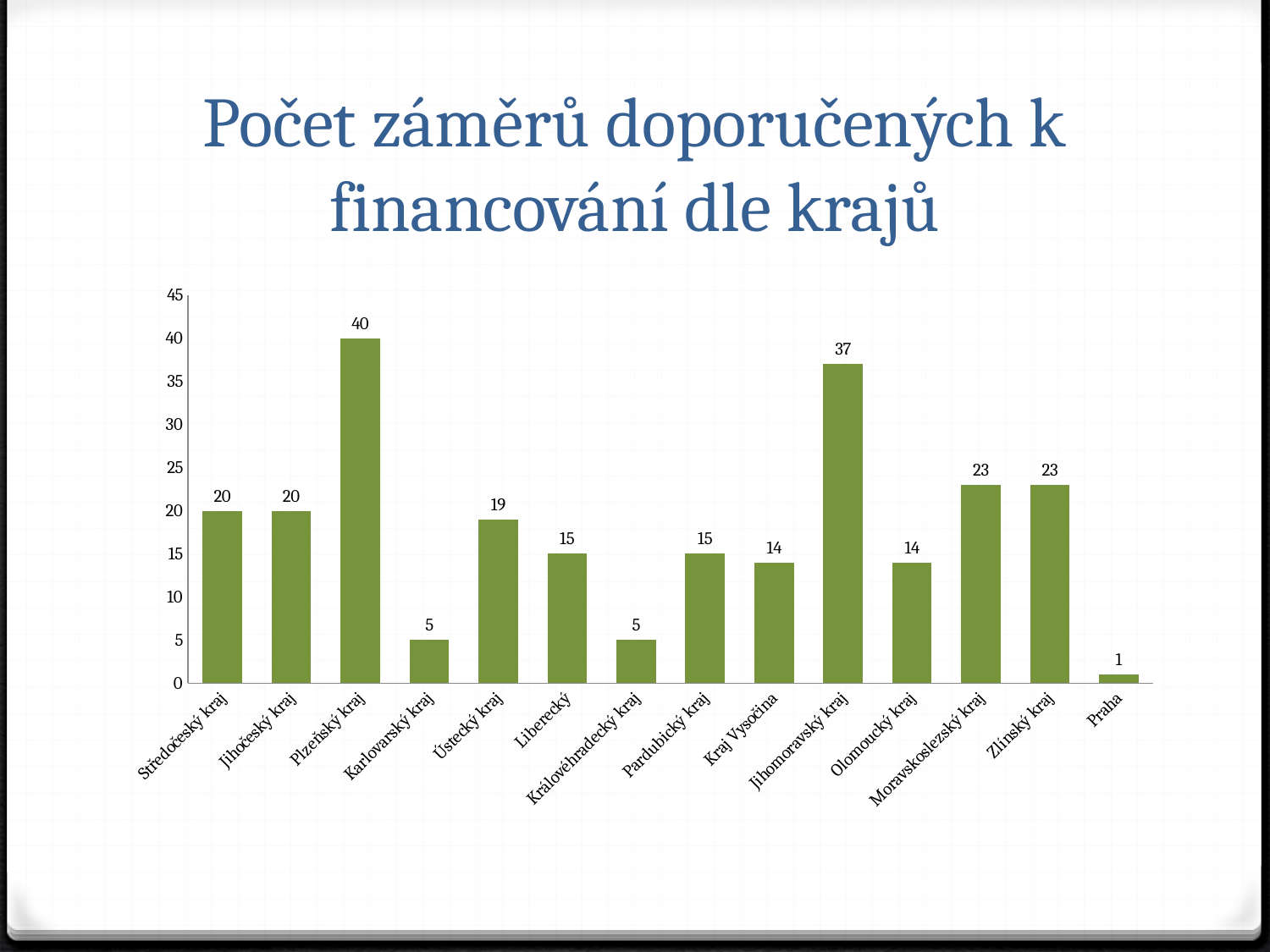
What is the difference between the values for Zlínský kraj and Olomoucký kraj? 9 What is the value for Plzeňský kraj? 40 How many categories are shown on the x axis? 14 What is the title of the slide? Počet záměrů doporučených k financování dle krajů Which is larger, the value for Ústecký kraj or the value for Liberecký? Ústecký kraj Is the value for Moravskoslezský kraj greater or less than 20? greater What is the difference between the values for Plzeňský kraj and Jihomoravský kraj? 3 What is the value for Jihomoravský kraj? 37 What is the value for Praha? 1 What kind of chart is shown on the slide? bar chart Which category has the highest value? Plzeňský kraj Which category has the lowest value? Praha